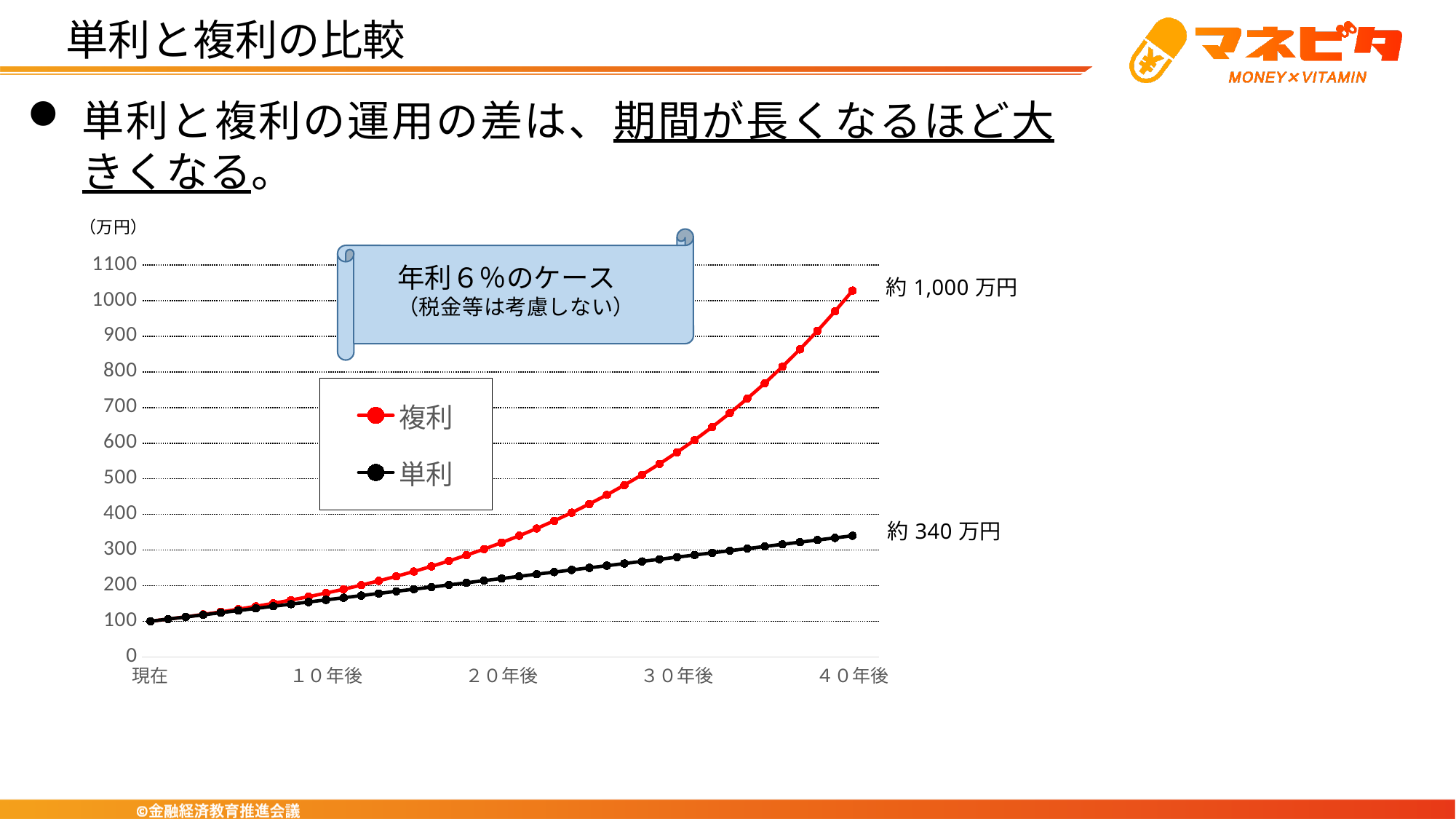
What value do both lines start at in 現在? 100 Is the value of the 複利 line at １０年後 greater or less than 200? less What annual interest rate does the callout on the chart say is assumed? 年利６％ Is the value of the 単利 line at ２０年後 greater or less than 300? less Do the values of the 複利 line rise or fall from 現在 to ４０年後? rise What type of chart is shown on the slide? line chart Is the value of the 複利 line at ３０年後 greater or less than 500? greater How many series does the chart legend list? 2 What are the two series named in the chart legend? 複利 and 単利 At ４０年後, which series has the larger value, 複利 or 単利? 複利 What value label is printed at the end of the 単利 line at ４０年後? 約 340 万円 What value label is printed at the end of the 複利 line at ４０年後? 約 1,000 万円